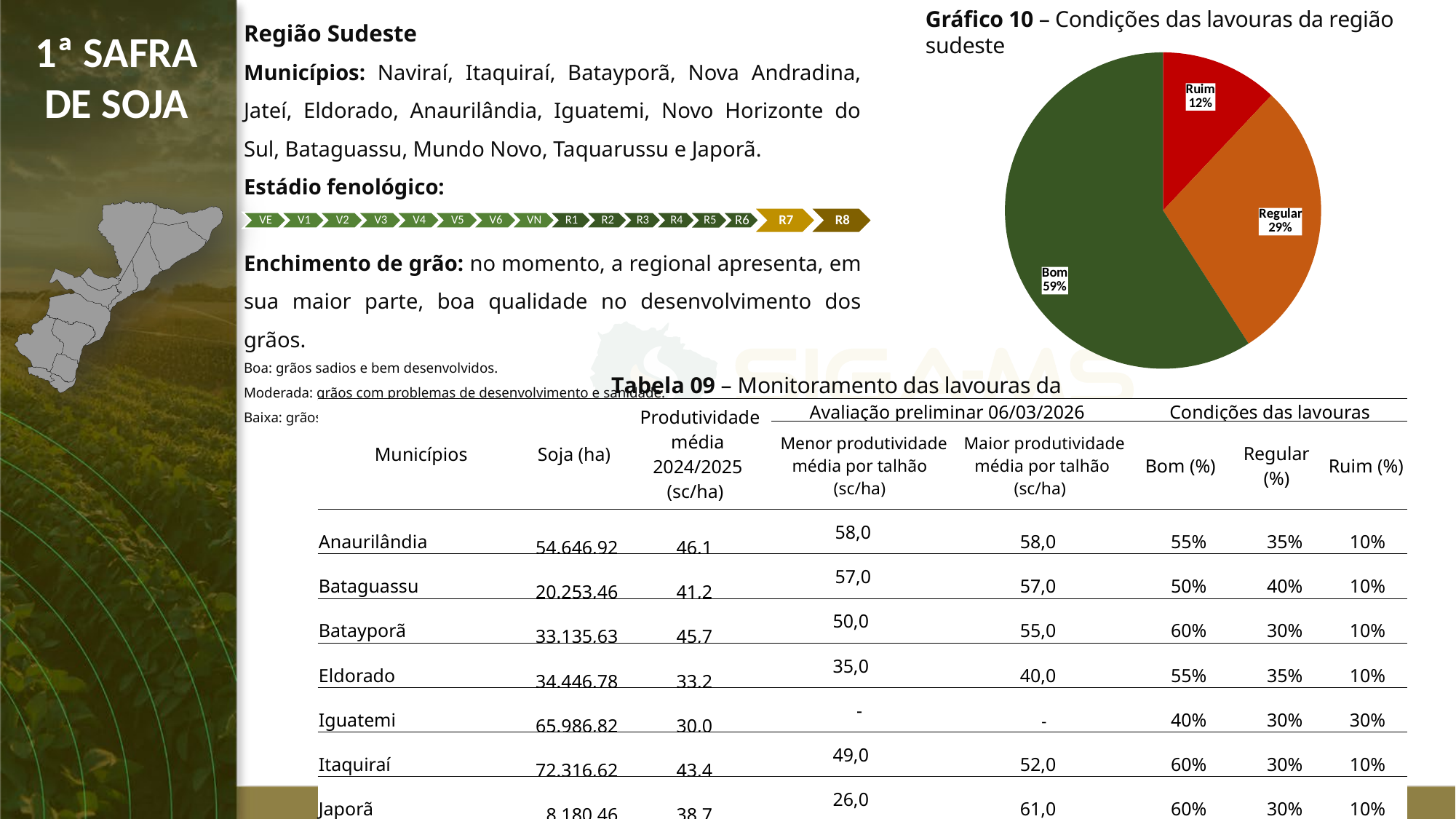
In Gráfico 10, which condition category has the smallest slice? Ruim In Gráfico 10, what share of the lavouras is rated Regular? 29% What kind of chart is Gráfico 10? pie chart In Gráfico 10, how many slices does the pie chart have? 3 In Gráfico 10, which condition category has the largest slice? Bom In Gráfico 10, what share of the lavouras is rated Bom? 59% What is the title of the pie chart on the slide? Gráfico 10 – Condições das lavouras da região sudeste In Gráfico 10, what is the difference in percentage points between the Regular and Ruim slices? 17 In Gráfico 10, which slice is larger, Regular or Ruim? Regular In Gráfico 10, what share of the lavouras is rated Ruim? 12% In Gráfico 10, what is the difference in percentage points between the Bom and Regular slices? 30 In Gráfico 10, what colour is the Bom slice? dark green